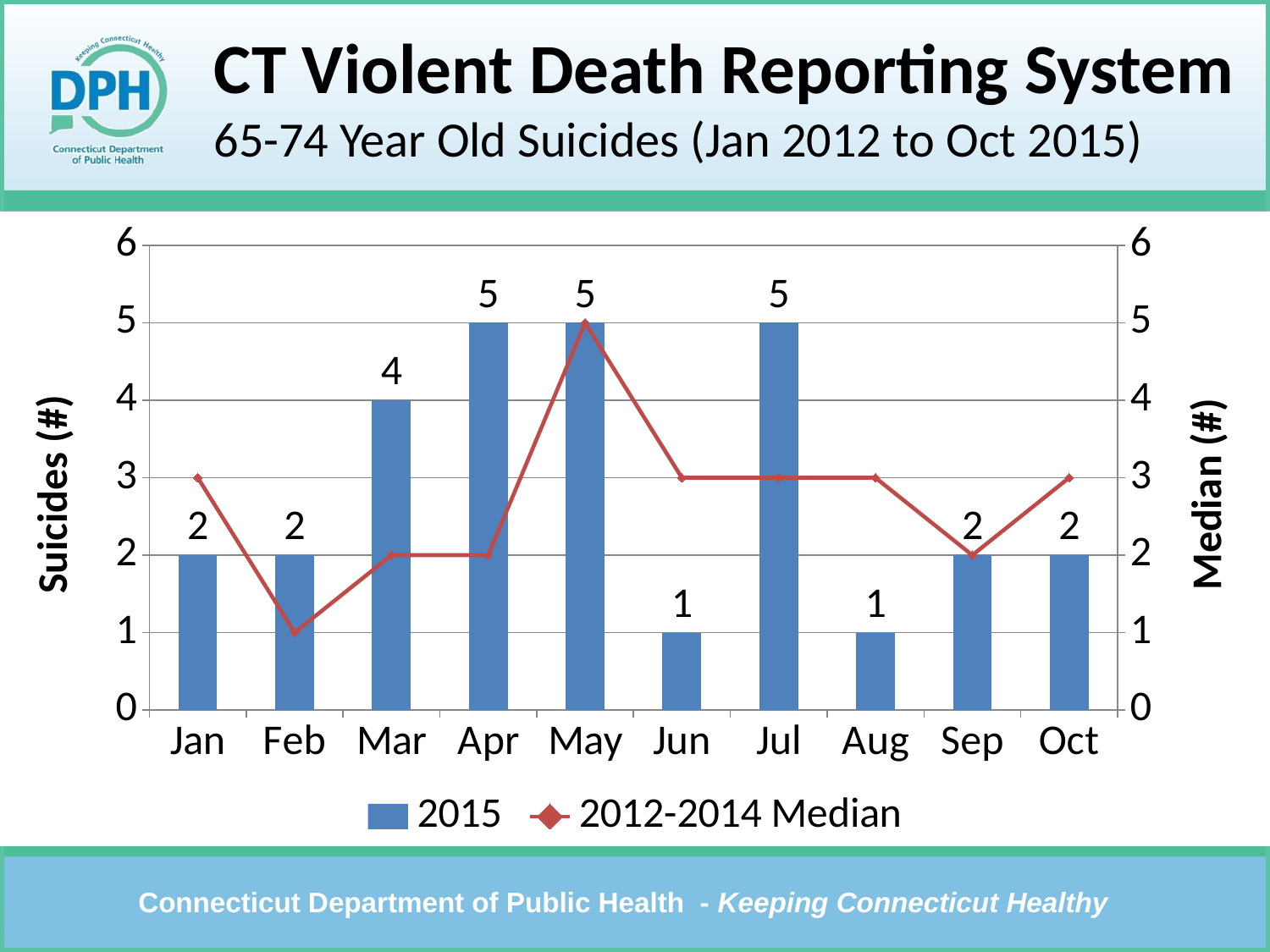
What is the number of suicides for 2015 in June? 1 What is the label of the right-hand vertical axis? Median (#) Which months have the highest 2015 suicide count? Apr, May, Jul Which months have the lowest 2015 suicide count? Jun, Aug Which is larger, the 2015 value for January or the 2012-2014 Median value for January? 2012-2014 Median What is the difference between the 2015 suicide counts for April and June? 4 What is the number of suicides for 2015 in March? 4 How many series does the legend list? 2 What is the 2012-2014 Median value for February? 1 What is the 2012-2014 Median value for May? 5 How many months are shown on the x axis? 10 What kind of chart is shown on the slide? Combined bar and line chart